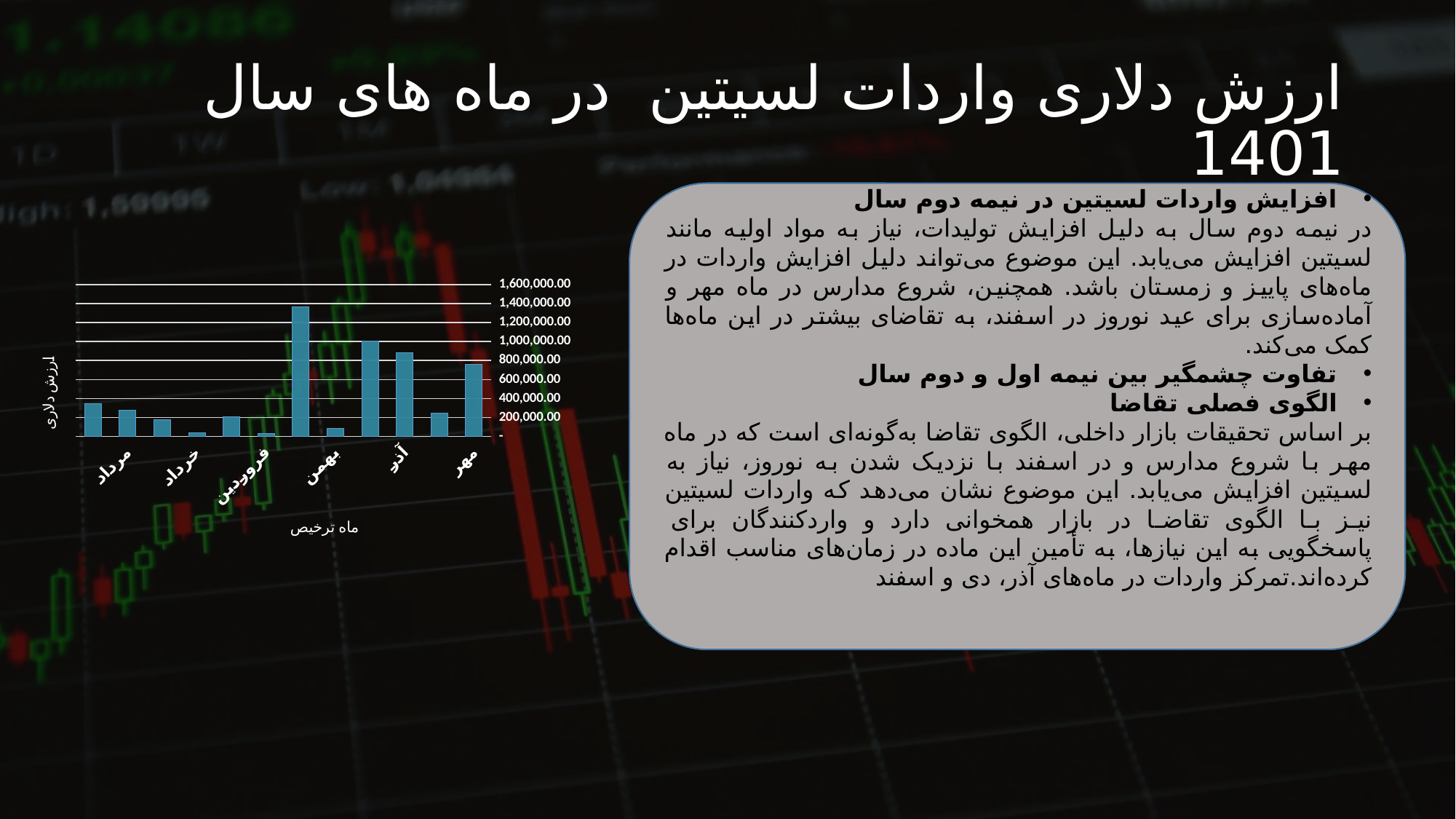
How many bars in the chart exceed 600,000? 4 What is the title of the horizontal axis of the chart? ماه ترخیص How many data series does the chart plot? 1 What kind of chart is shown on the slide? bar chart Is the value of the tallest bar greater or less than 1,200,000? greater What is the highest tick value shown on the vertical axis? 1,600,000.00 How many bars are plotted in the chart? 12 How many category labels are printed along the horizontal axis? 6 Is the value of the shortest bar greater or less than 200,000? less What is the title of the vertical axis of the chart? ارزش دلاری